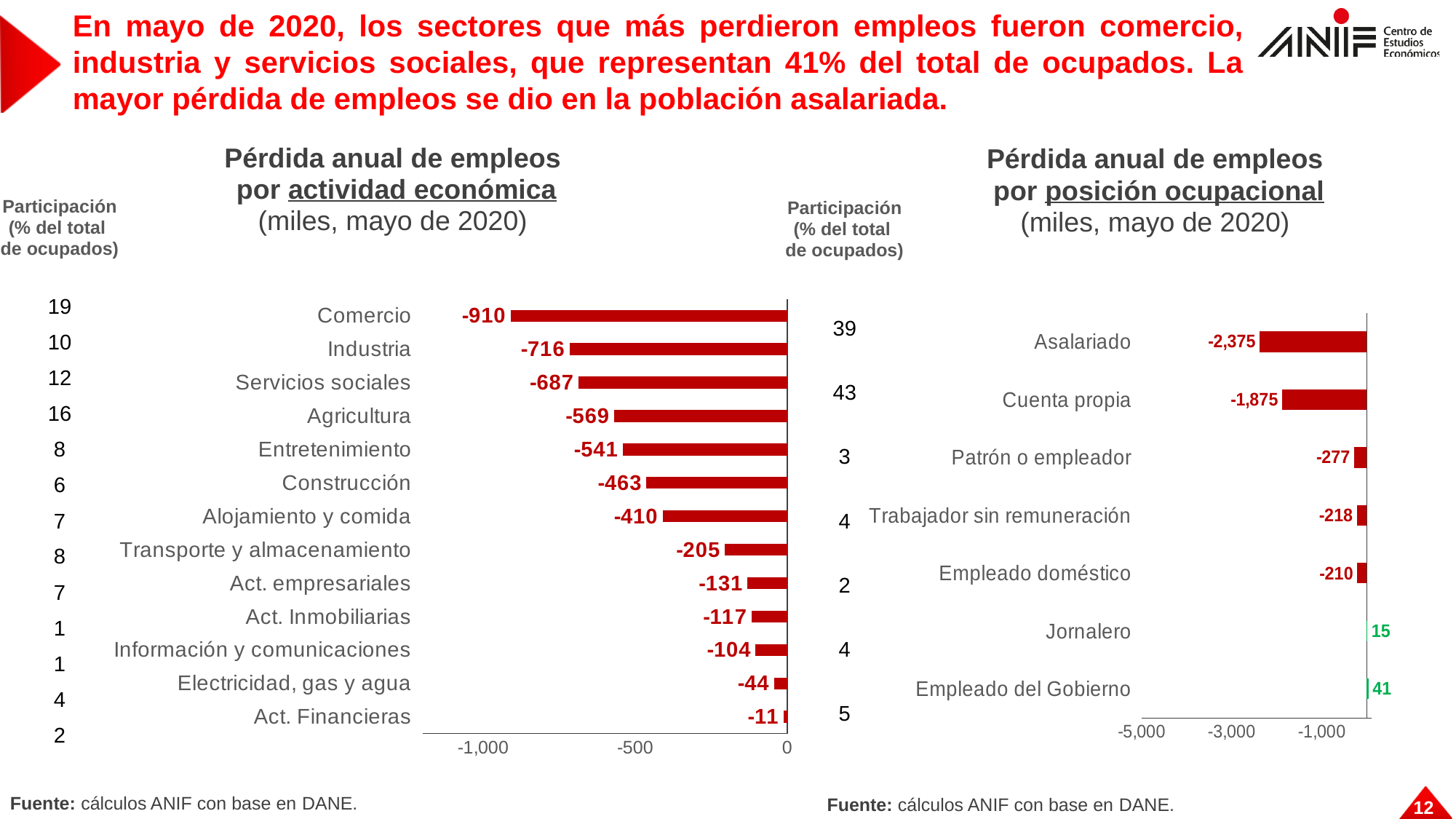
In the chart 'Pérdida anual de empleos por actividad económica', what is the value for Construcción? -463 In the chart 'Pérdida anual de empleos por actividad económica', which category has the smallest job loss (value closest to zero)? Act. Financieras In the chart 'Pérdida anual de empleos por actividad económica', what is the difference between the values for Industria and Servicios sociales? 29 In the chart 'Pérdida anual de empleos por actividad económica', what is the value for Comercio? -910 In the chart 'Pérdida anual de empleos por posición ocupacional', how many categories are plotted? 7 In the chart 'Pérdida anual de empleos por posición ocupacional', what is the value for Empleado del Gobierno? 41 In the chart 'Pérdida anual de empleos por actividad económica', how many categories are plotted? 13 In the chart 'Pérdida anual de empleos por posición ocupacional', what is the value for Asalariado? -2,375 In the chart 'Pérdida anual de empleos por actividad económica', which category has the largest job loss (most negative value)? Comercio In the chart 'Pérdida anual de empleos por posición ocupacional', which category has the largest job loss (most negative value)? Asalariado In the chart 'Pérdida anual de empleos por posición ocupacional', which is larger in magnitude, the loss for Patrón o empleador or for Empleado doméstico? Patrón o empleador What type of chart is 'Pérdida anual de empleos por posición ocupacional'? Bar chart